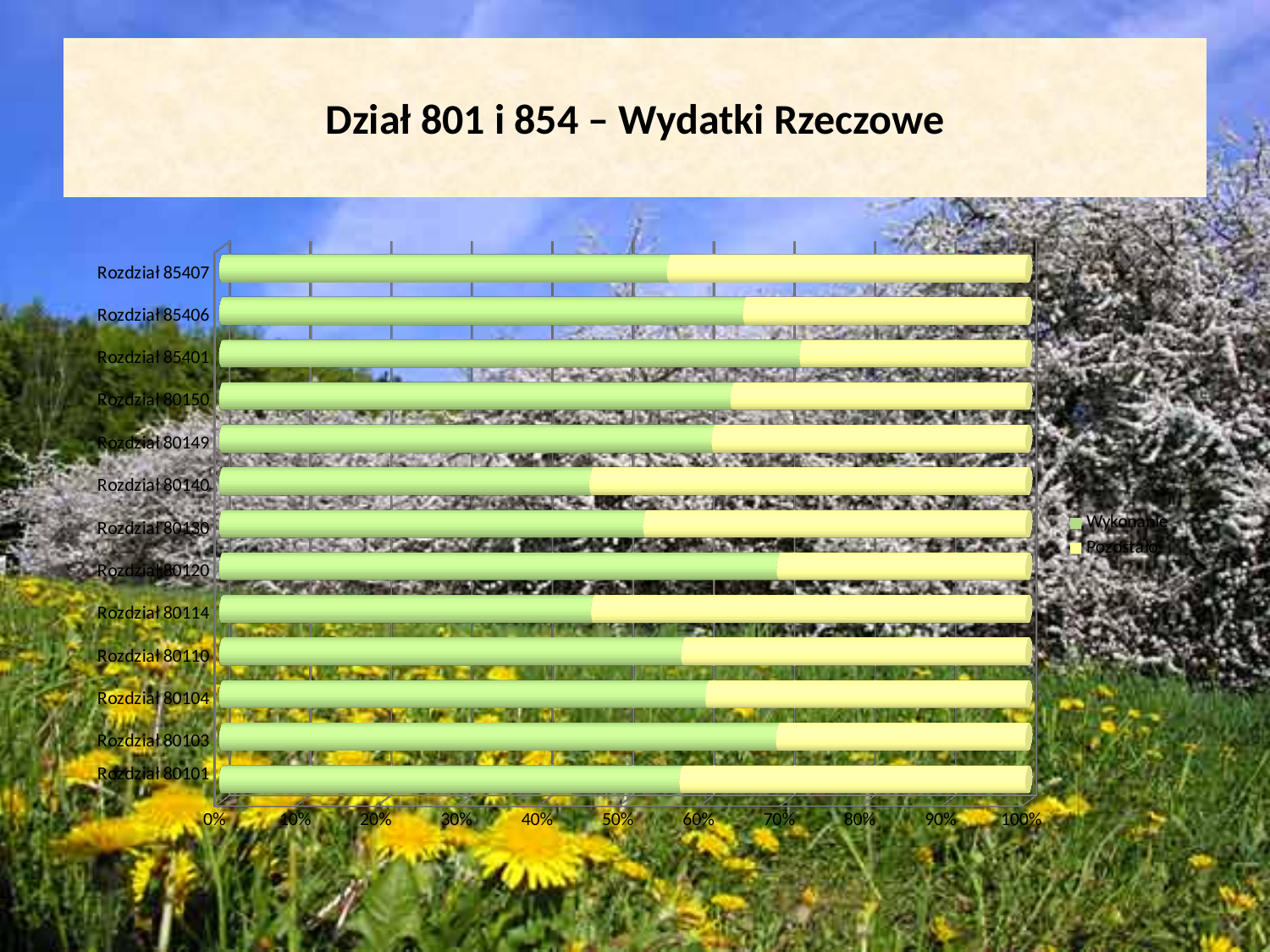
Is the Wykonanie value for Rozdział 85401 greater or less than 70%? greater Which category has the largest Wykonanie share? Rozdział 85401 What is the total of the stacked bar for Rozdział 80101? 100% What kind of chart is shown on the slide? bar chart What is the title of the slide? Dział 801 i 854 – Wydatki Rzeczowe Is the Wykonanie value for Rozdział 85407 greater or less than 50%? greater Which has the larger Wykonanie share, Rozdział 85401 or Rozdział 80140? Rozdział 85401 How many categories (Rozdział bars) are shown in the chart? 13 How many series does the legend list? 2 What are the two series named in the legend? Wykonanie and Pozostało Is the Wykonanie value for Rozdział 80140 greater or less than 50%? less